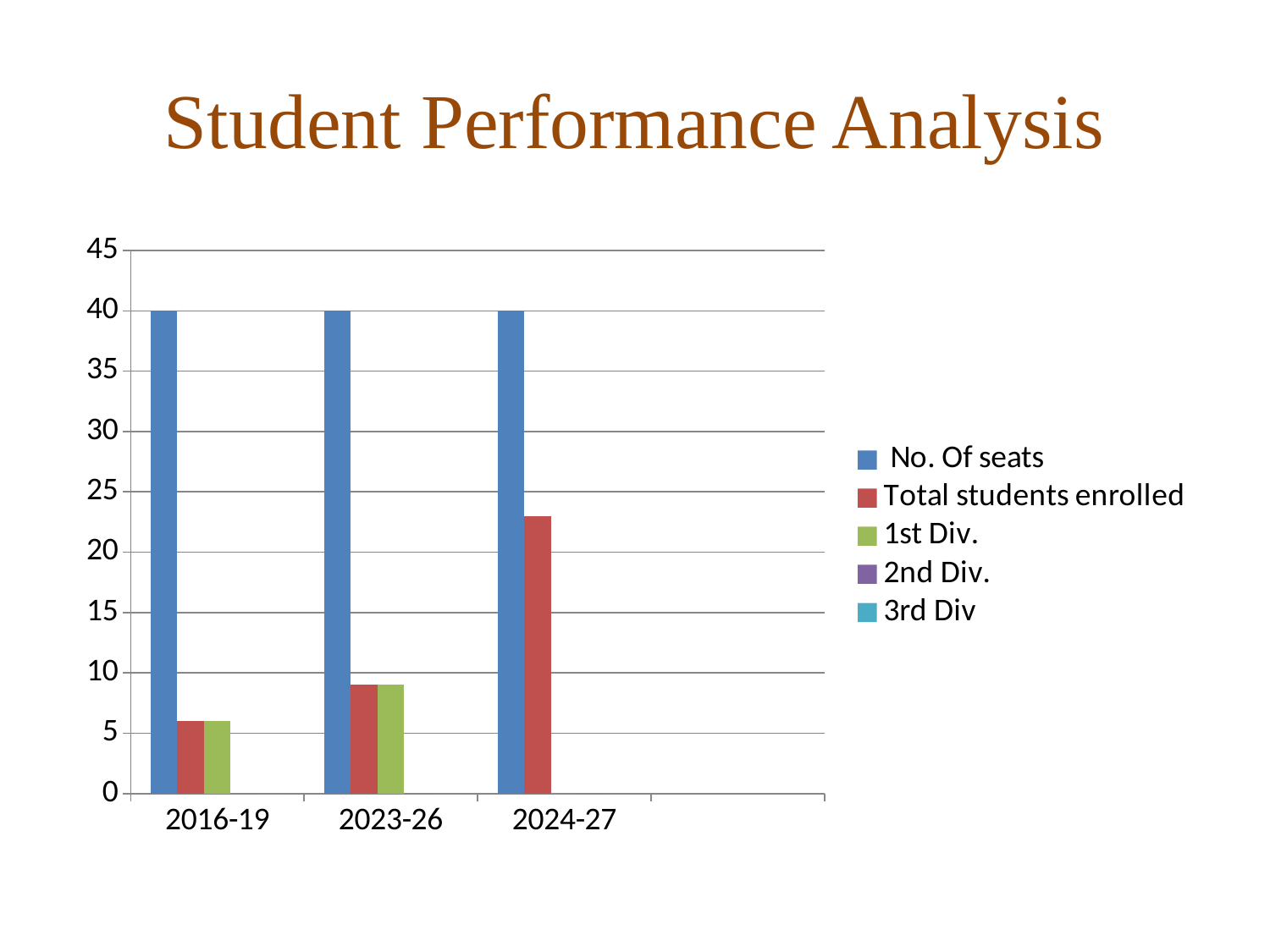
What is the value of No. Of seats for 2016-19? 40 Is the value for 1st Div. in 2023-26 greater or less than 5? greater Which category has the highest Total students enrolled? 2024-27 How many categories are shown on the x axis? 3 How many series does the legend list? 5 What colour are the No. Of seats bars? blue What kind of chart is shown on the slide? bar chart Which is larger, Total students enrolled for 2024-27 or for 2023-26? 2024-27 What is the value of No. Of seats for 2024-27? 40 Is the value for Total students enrolled in 2024-27 greater or less than 20? greater Which category has the lowest Total students enrolled? 2016-19 Is the value for Total students enrolled in 2016-19 greater or less than 10? less